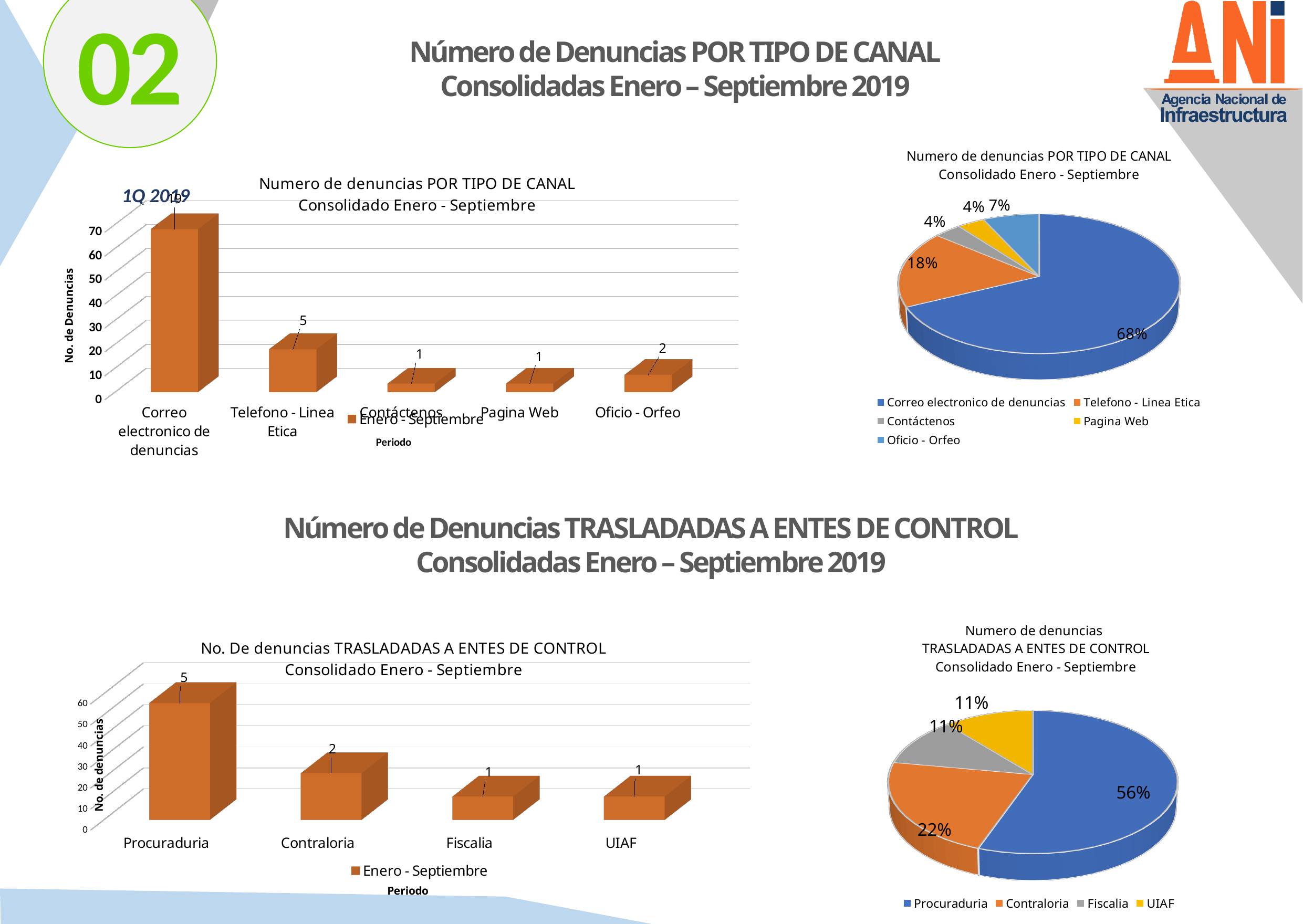
In the top-left bar chart (Numero de denuncias POR TIPO DE CANAL), what is the value for Oficio - Orfeo? 2 In the bottom-left bar chart (No. De denuncias TRASLADADAS A ENTES DE CONTROL), which is larger, the value for Contraloria or the value for Fiscalia? Contraloria In the top-left bar chart (Numero de denuncias POR TIPO DE CANAL), which category has the highest value? Correo electronico de denuncias In the top-left bar chart (Numero de denuncias POR TIPO DE CANAL), how many categories are shown on the x axis? 5 In the top-left bar chart (Numero de denuncias POR TIPO DE CANAL), what is the value for Telefono - Linea Etica? 5 In the top-left bar chart (Numero de denuncias POR TIPO DE CANAL), what is the difference between the values for Telefono - Linea Etica and Oficio - Orfeo? 3 In the bottom-right pie chart (Numero de denuncias TRASLADADAS A ENTES DE CONTROL), what share does Contraloria have? 22% In the top-right pie chart (Numero de denuncias POR TIPO DE CANAL), how many entries does the legend list? 5 In the top-right pie chart (Numero de denuncias POR TIPO DE CANAL), what share does Telefono - Linea Etica have? 18% In the bottom-left bar chart (No. De denuncias TRASLADADAS A ENTES DE CONTROL), what is the value for Procuraduria? 5 What kind of chart is the bottom-left chart (No. De denuncias TRASLADADAS A ENTES DE CONTROL)? Bar chart In the top-right pie chart (Numero de denuncias POR TIPO DE CANAL), what share does Correo electronico de denuncias have? 68%